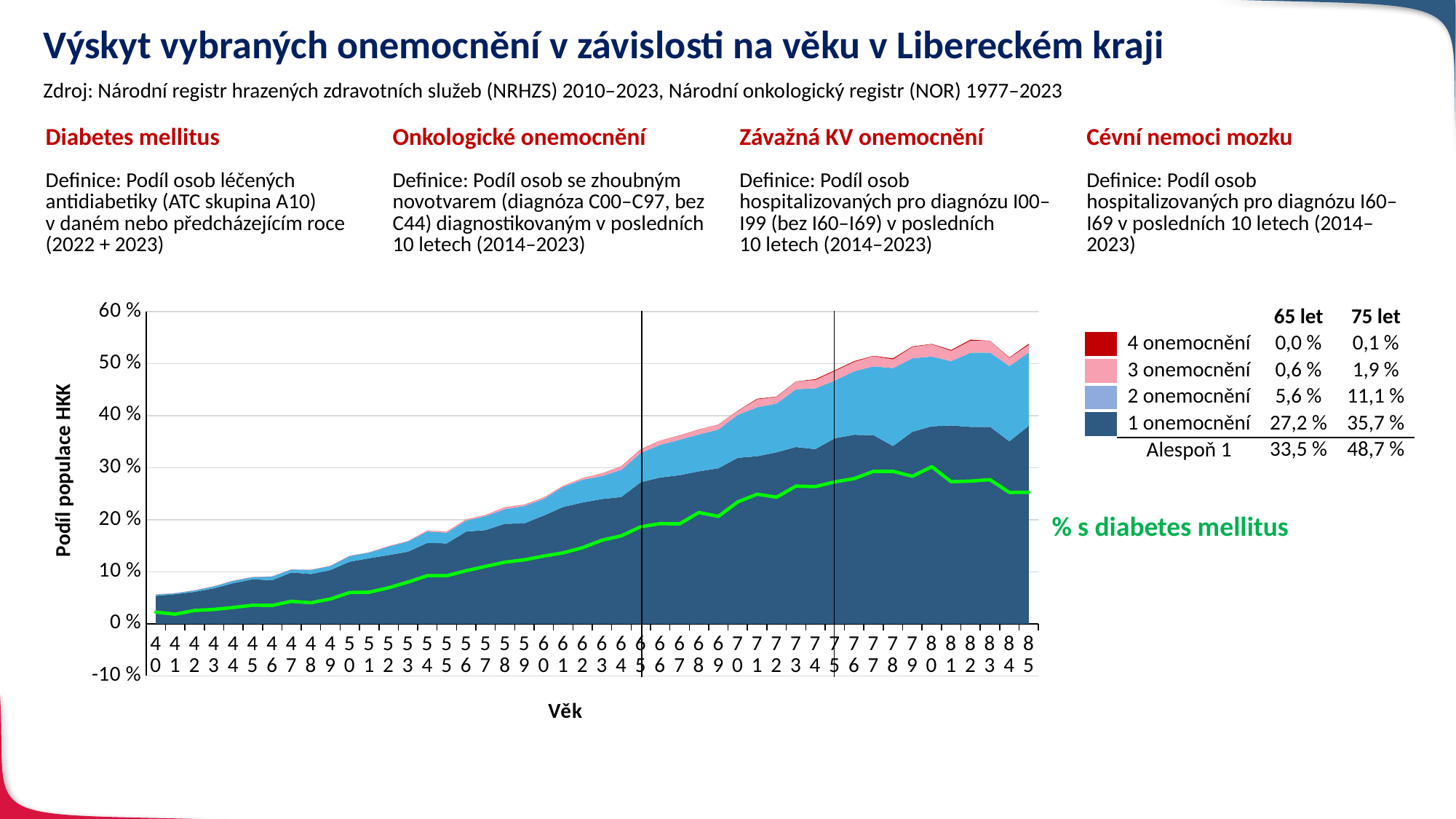
Is the green '% s diabetes mellitus' line at age 85 greater or less than 20 %? greater According to the table next to the chart, what is the value for '2 onemocnění' at 75 let? 11,1 % According to the table next to the chart, what is the value for '1 onemocnění' at 75 let? 35,7 % Is the total stacked value at age 85 greater or less than 50 %? greater How many age categories are shown on the x axis? 46 What is the difference between the 'Alespoň 1' values at 75 let and 65 let in the table? 15,2 % Which is larger in the table: '3 onemocnění' at 65 let or '3 onemocnění' at 75 let? 75 let Is the total stacked value at age 40 greater or less than 10 %? less What kind of chart is shown on the slide? Stacked area chart with a line According to the table next to the chart, what is the value for '1 onemocnění' at 65 let? 27,2 % What is the label of the y axis? Podíl populace HKK According to the table next to the chart, what is the value for 'Alespoň 1' at 75 let? 48,7 %